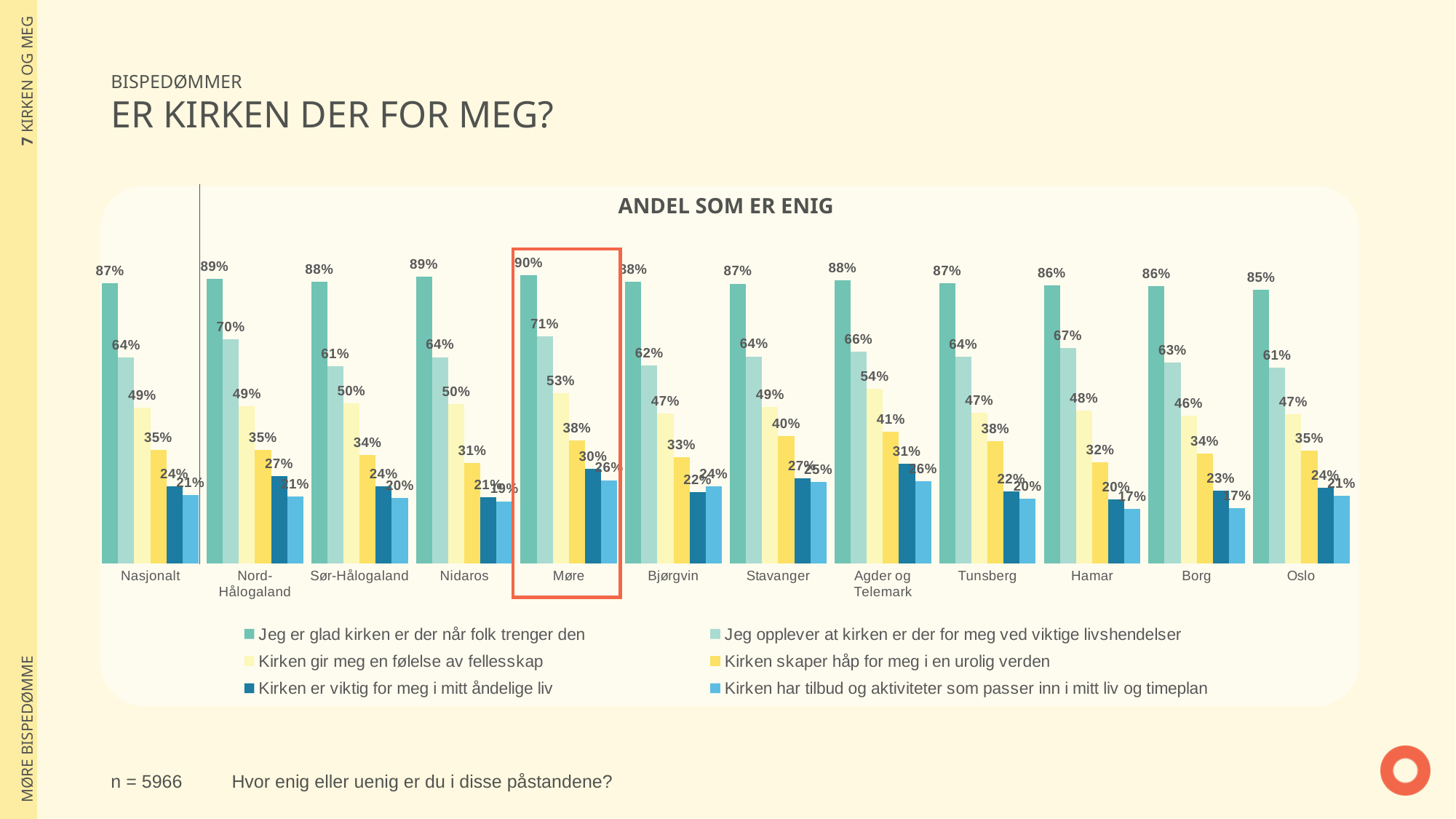
Which category has the lowest value in the series "Jeg er glad kirken er der når folk trenger den"? Oslo What kind of chart is shown on the slide? Bar chart What is the title of the chart? ANDEL SOM ER ENIG What is the value for Møre in the series "Jeg er glad kirken er der når folk trenger den"? 90% What is the value for Agder og Telemark in the series "Kirken gir meg en følelse av fellesskap"? 54% Which category is highlighted with a red box on the chart? Møre How many categories are shown on the x axis? 12 What is the value for Stavanger in the series "Kirken skaper håp for meg i en urolig verden"? 40% What is the difference between Møre and Nasjonalt in the series "Kirken er viktig for meg i mitt åndelige liv"? 6% Which category has the highest value in the series "Jeg opplever at kirken er der for meg ved viktige livshendelser"? Møre Which is larger in the series "Kirken skaper håp for meg i en urolig verden": Agder og Telemark or Hamar? Agder og Telemark How many series does the legend list? 6